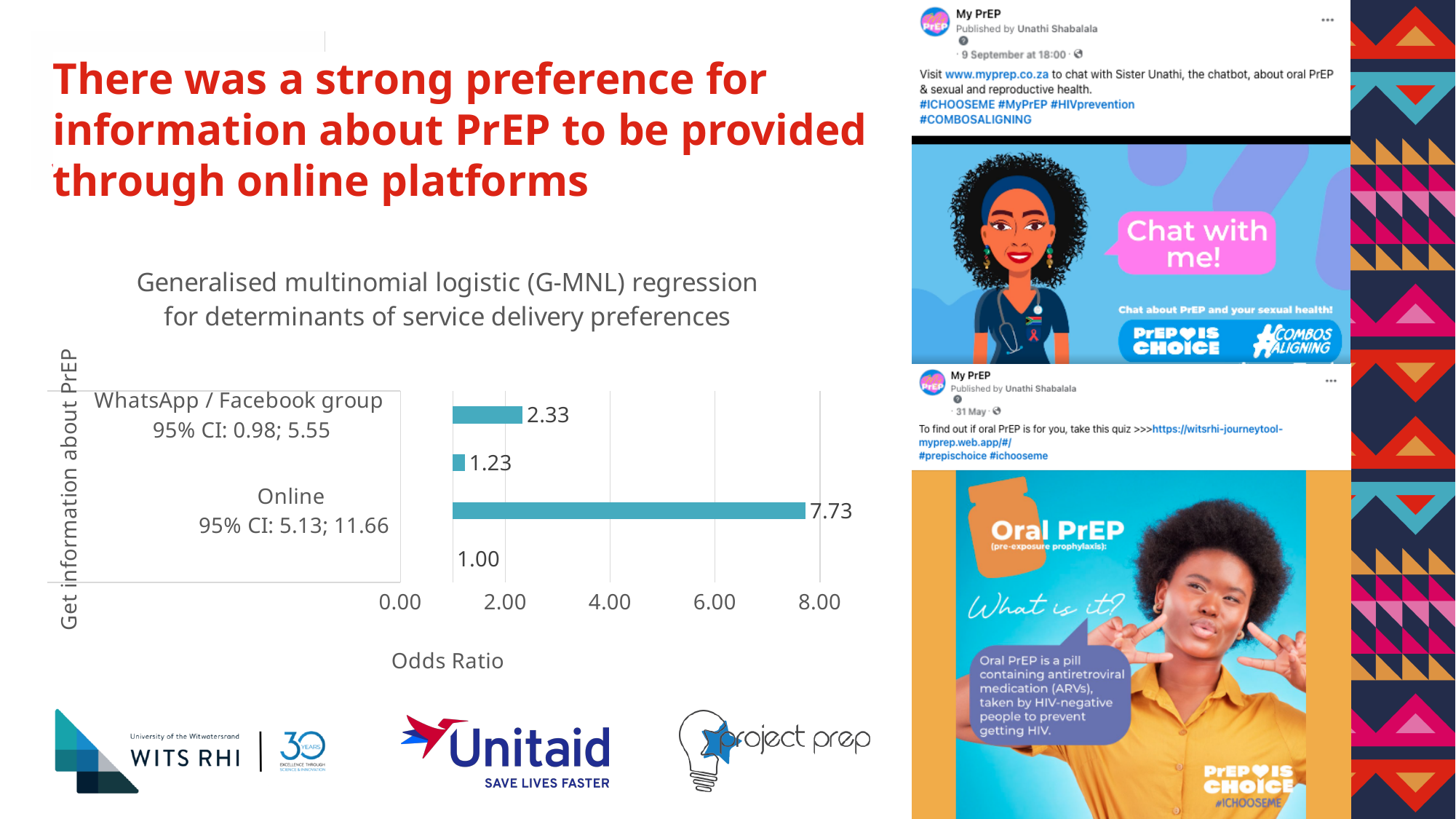
Which category has the highest odds ratio in the chart? Online What 95% confidence interval is shown for the WhatsApp / Facebook group category? 0.98; 5.55 What is the difference between the odds ratio for Online and the odds ratio for WhatsApp / Facebook group? 5.40 What is the odds ratio shown for the Online category? 7.73 What is the odds ratio shown for the WhatsApp / Facebook group category? 2.33 Is the odds ratio for WhatsApp / Facebook group greater or less than 4.00? less Is the odds ratio for Online greater or less than 6.00? greater What is the title of the chart? Generalised multinomial logistic (G-MNL) regression for determinants of service delivery preferences Which has a larger odds ratio, Online or WhatsApp / Facebook group? Online What is the label of the horizontal axis of the chart? Odds Ratio What kind of chart is shown on the slide? Bar chart What 95% confidence interval is shown for the Online category? 5.13; 11.66